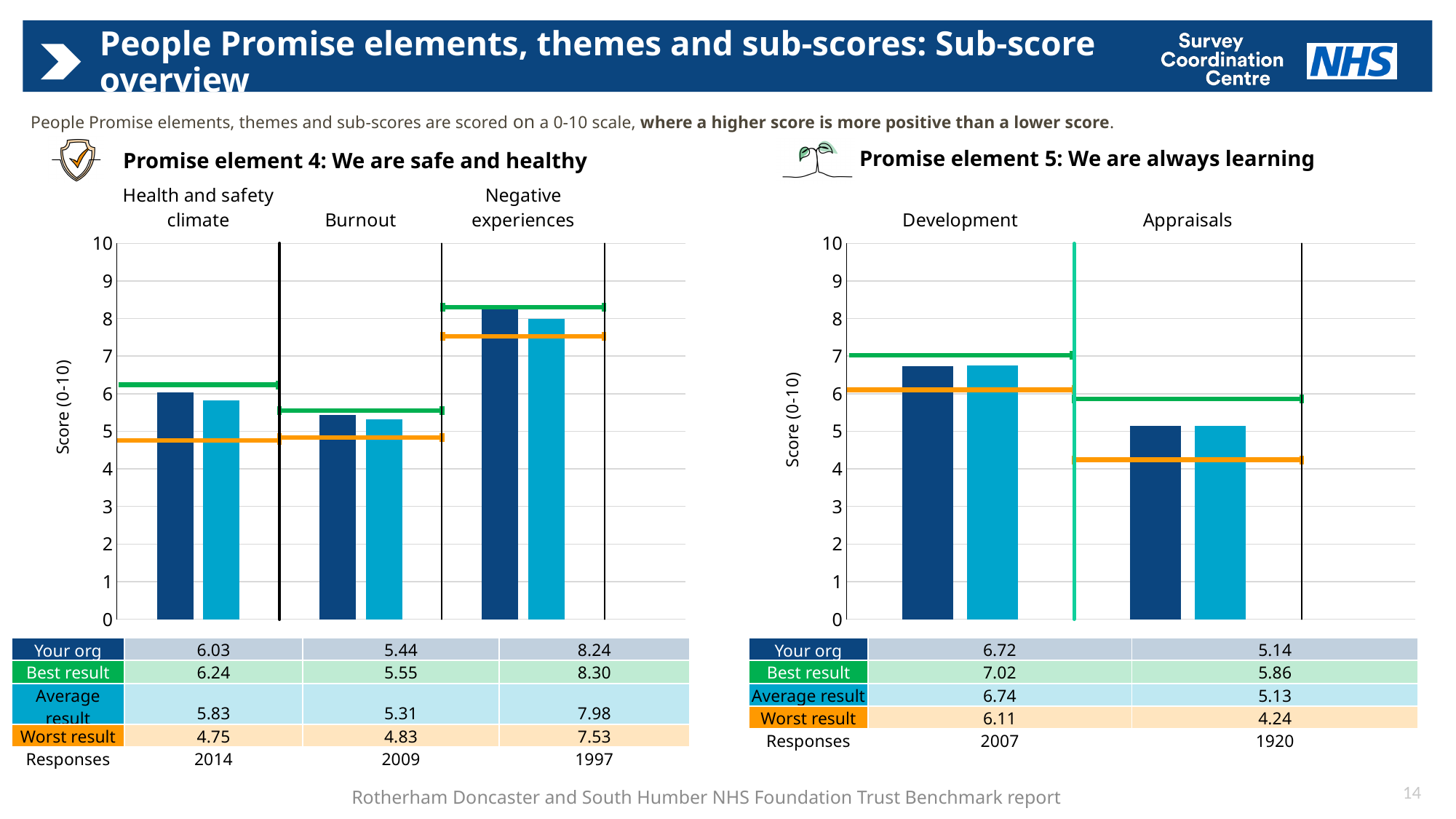
In the 'Promise element 4: We are safe and healthy' chart, what is the difference between the 'Your org' score and the Average result for Health and safety climate? 0.20 In the 'Promise element 5: We are always learning' chart, what is the Average result for Development? 6.74 In the 'Promise element 5: We are always learning' chart, is the 'Your org' score for Development higher or lower than the Average result for Development? lower In the 'Promise element 5: We are always learning' chart, what is the Worst result for Appraisals? 4.24 In the 'Promise element 4: We are safe and healthy' chart, which sub-score has the lowest 'Your org' value? Burnout How many sub-scores are shown in the 'Promise element 4: We are safe and healthy' chart? 3 In the 'Promise element 4: We are safe and healthy' chart, what is the 'Your org' score for Burnout? 5.44 In the 'Promise element 4: We are safe and healthy' chart, what is the Best result for Negative experiences? 8.30 In the 'Promise element 4: We are safe and healthy' chart, which sub-score has the highest 'Your org' value? Negative experiences What kind of chart is used for 'Promise element 5: We are always learning'? bar chart In the 'Promise element 4: We are safe and healthy' chart, is the 'Your org' score for Negative experiences greater or less than 8? greater In the 'Promise element 5: We are always learning' chart, what is the difference between the Best result and the Worst result for Appraisals? 1.62